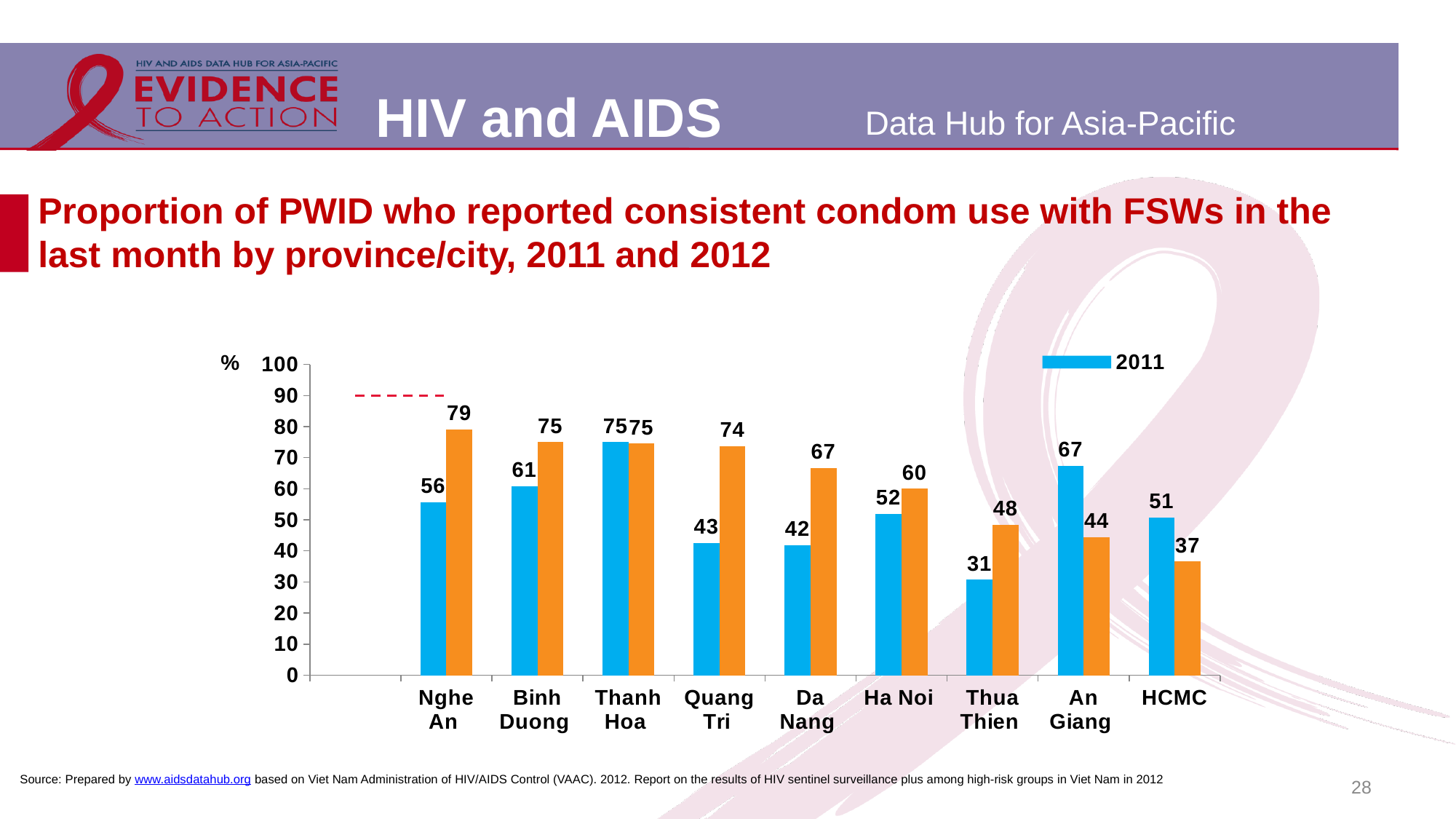
Which province/city has the highest orange (2012) bar? Nghe An What is the 2011 value for An Giang? 67 Is the 2011 value for Da Nang greater or less than 50? less What is the orange (2012) bar value for Quang Tri? 74 Which province/city has the lowest 2011 value? Thua Thien What colour are the 2011 bars? blue What is the difference between the 2012 and 2011 values for Quang Tri? 31 What kind of chart is shown on the slide? bar chart What is the difference between the 2011 and 2012 values for HCMC? 14 What is the 2011 value for Nghe An? 56 How many provinces/cities are shown on the x axis? 9 For An Giang, which is larger: the 2011 value or the 2012 value? 2011